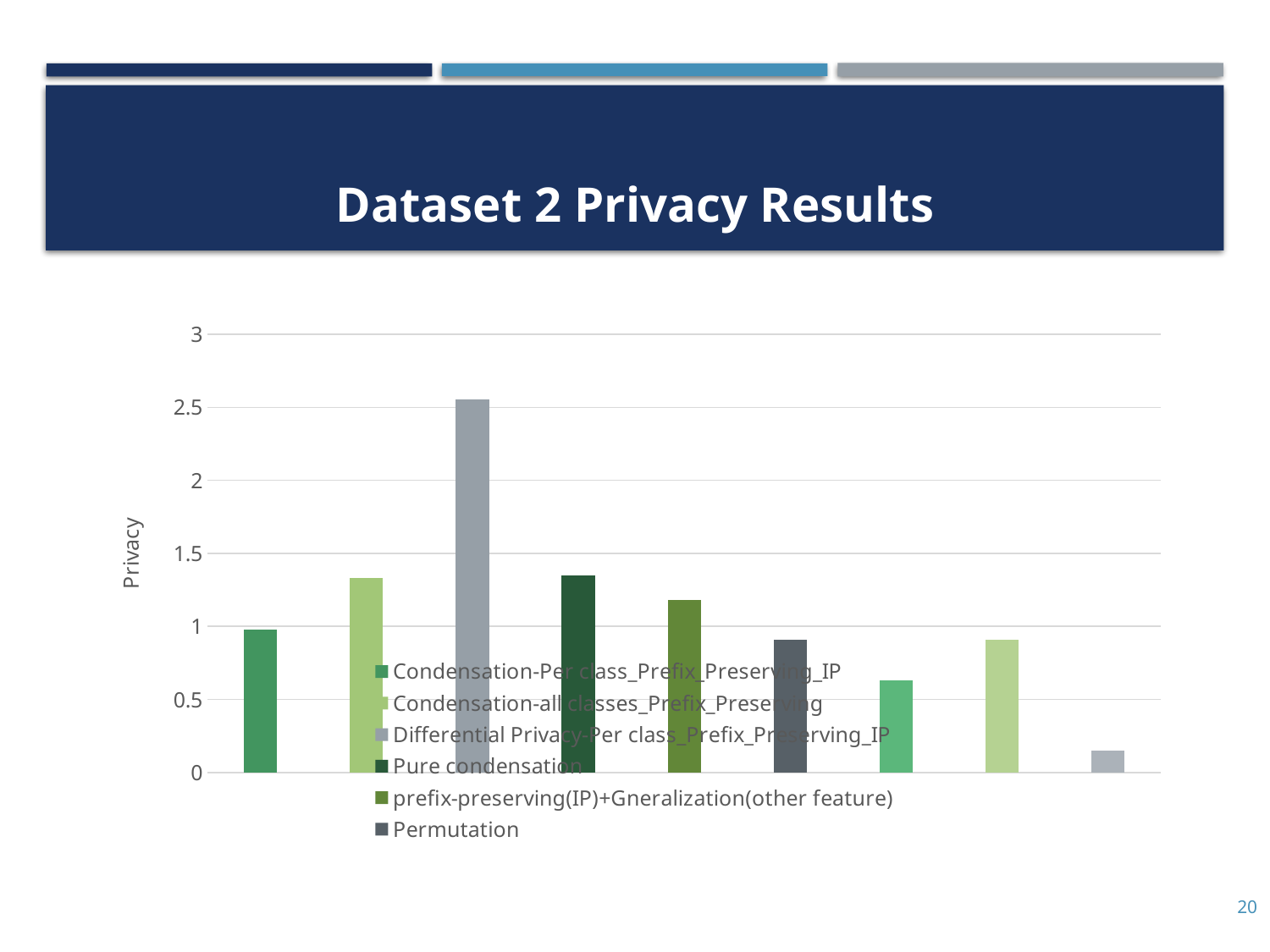
How many bars are plotted in the chart? 9 Is the value of the Pure condensation bar greater or less than 1? greater What kind of chart is shown on the slide? bar chart Is the value of the Permutation bar greater or less than 1? less What is the title of the slide containing the chart? Dataset 2 Privacy Results Is the value of the prefix-preserving(IP)+Gneralization(other feature) bar greater or less than 1.5? less What is the label on the vertical axis of the chart? Privacy Which is larger: the tallest Differential Privacy-Per class_Prefix_Preserving_IP bar or the Pure condensation bar? Differential Privacy-Per class_Prefix_Preserving_IP How many series does the chart legend list? 6 Which series has the tallest bar in the chart? Differential Privacy-Per class_Prefix_Preserving_IP Which is larger: the prefix-preserving(IP)+Gneralization(other feature) bar or the Permutation bar? prefix-preserving(IP)+Gneralization(other feature)